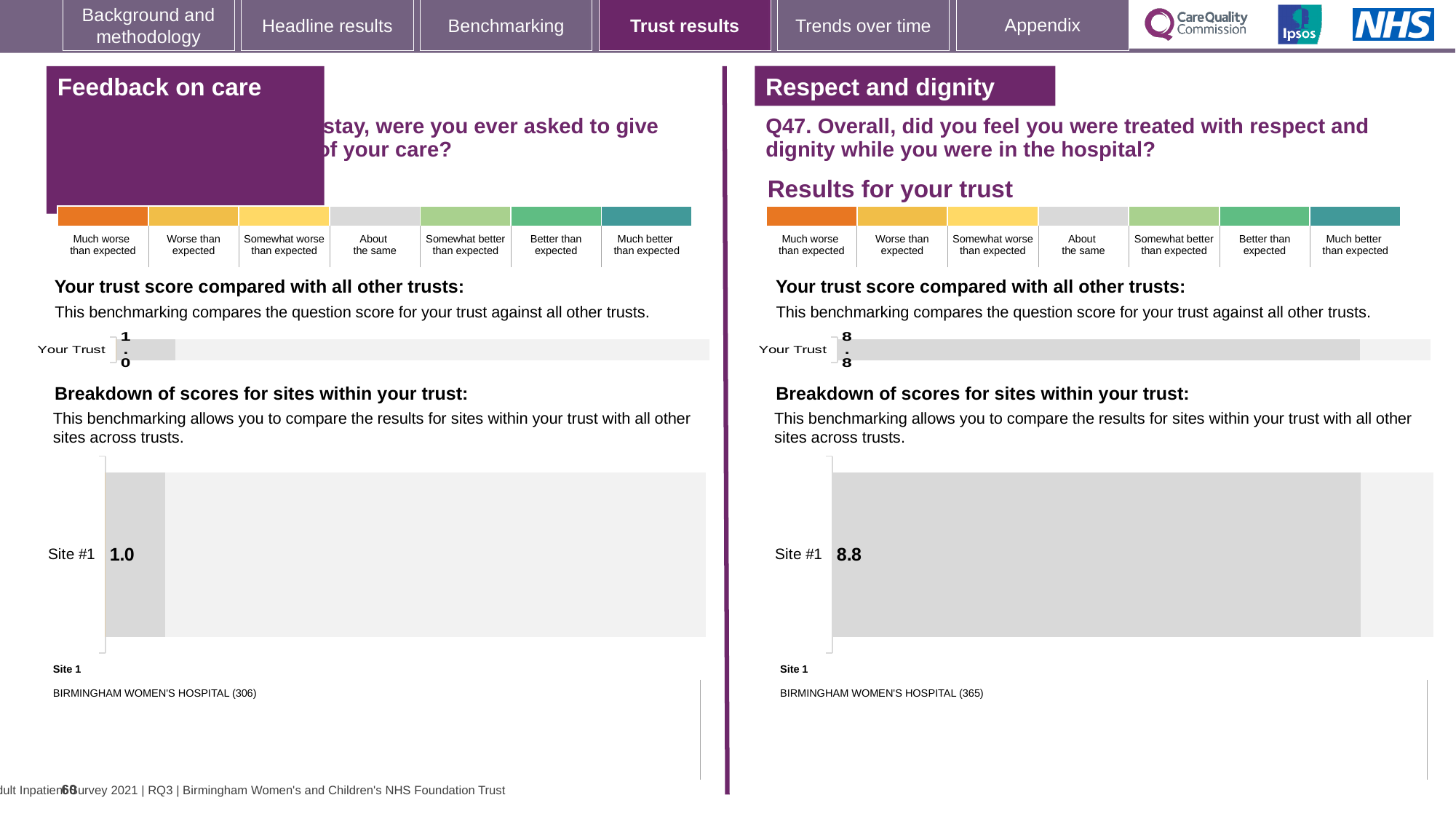
In the 'Feedback on care' section, which site name is listed as Site 1 below the chart? BIRMINGHAM WOMEN'S HOSPITAL (306) In the 'Respect and dignity' section, which site name is listed as Site 1 below the chart? BIRMINGHAM WOMEN'S HOSPITAL (365) How many sites are shown in the 'Feedback on care' breakdown of scores chart? 1 What is the difference between the Site #1 score in the 'Respect and dignity' chart and the Site #1 score in the 'Feedback on care' chart? 7.8 On the 'Feedback on care' section, what is the value shown for 'Your Trust' in the trust score chart? 1.0 How many sites are shown in the 'Respect and dignity' breakdown of scores chart? 1 On the 'Feedback on care' section, what is the score shown for Site #1 in the breakdown of scores chart? 1.0 On the 'Respect and dignity' section, what is the value shown for 'Your Trust' in the trust score chart? 8.8 What kind of chart is used to show the Site #1 score in the 'Feedback on care' breakdown of scores? Bar chart Is the 'Your Trust' value in the 'Respect and dignity' trust score chart greater or less than the 'Your Trust' value in the 'Feedback on care' trust score chart? greater On the 'Respect and dignity' section, what is the score shown for Site #1 in the breakdown of scores chart? 8.8 Which is larger: the Site #1 score in the 'Feedback on care' chart or the Site #1 score in the 'Respect and dignity' chart? Respect and dignity